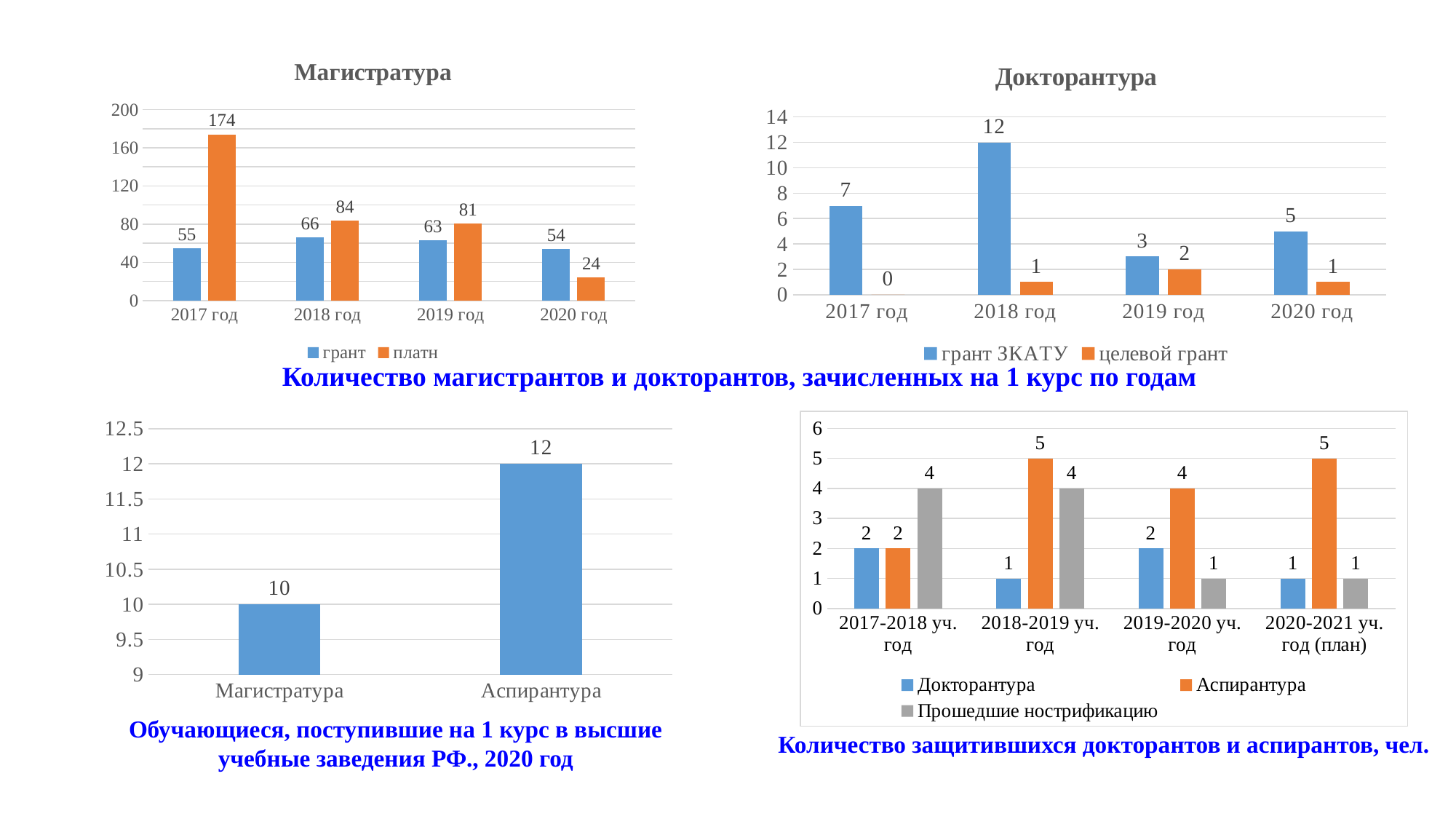
In the 'Магистратура' chart, which year has the lowest 'платн' value? 2020 год In the 'Докторантура' chart, what is the value for 'целевой грант' in 2017 год? 0 In the 'Докторантура' chart, which year has the highest 'грант ЗКАТУ' value? 2018 год In the bottom-left chart ('Обучающиеся, поступившие на 1 курс в высшие учебные заведения РФ., 2020 год'), how many categories are shown? 2 In the 'Магистратура' chart, what is the difference between 'платн' and 'грант' in 2018 год? 18 In the 'Количество защитившихся докторантов и аспирантов, чел.' chart, what is the value for 'Аспирантура' in 2018-2019 уч. год? 5 In the 'Количество защитившихся докторантов и аспирантов, чел.' chart, how many series does the legend list? 3 In the 'Докторантура' chart, what is the value for 'грант ЗКАТУ' in 2018 год? 12 In the 'Магистратура' chart, what is the value for 'платн' in 2017 год? 174 In the bottom-left chart ('Обучающиеся, поступившие на 1 курс в высшие учебные заведения РФ., 2020 год'), what is the value for 'Аспирантура'? 12 In the 'Магистратура' chart, how many series does the legend list? 2 What kind of chart is the 'Докторантура' chart? bar chart